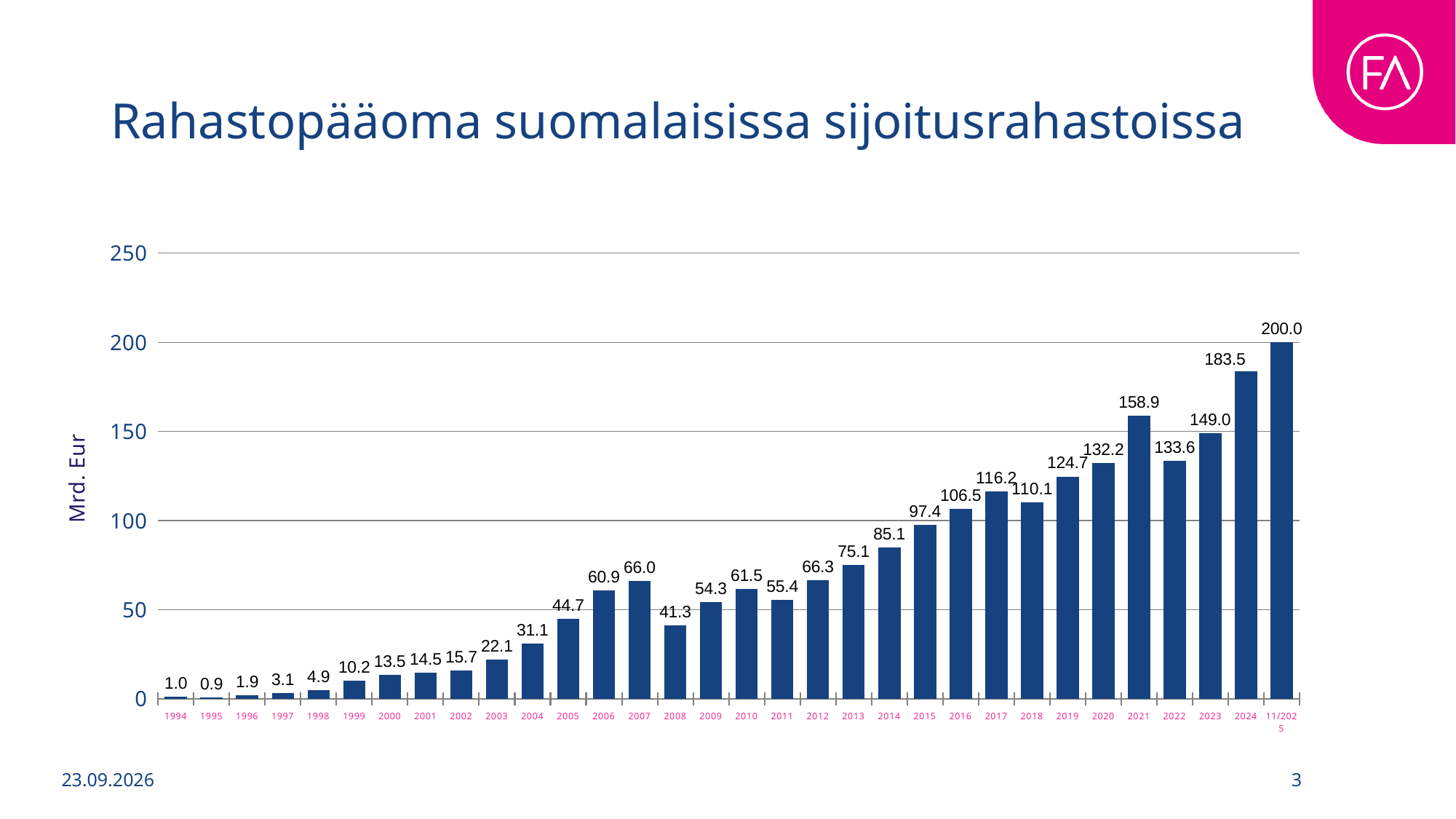
How many bars are shown in the chart? 32 Do the values generally rise or fall from 1994 to 11/2025? Rise What kind of chart is shown on the slide? Bar chart What is the value for 2008? 41.3 What is the value for 11/2025? 200.0 What is the label on the vertical axis? Mrd. Eur Which year has the lowest value? 1995 What is the difference between the values for 2024 and 2023? 34.5 Is the value for 2019 greater or less than 100? greater Which is larger, the value for 2007 or the value for 2009? 2007 Which category has the highest value? 11/2025 What is the value for 2021? 158.9